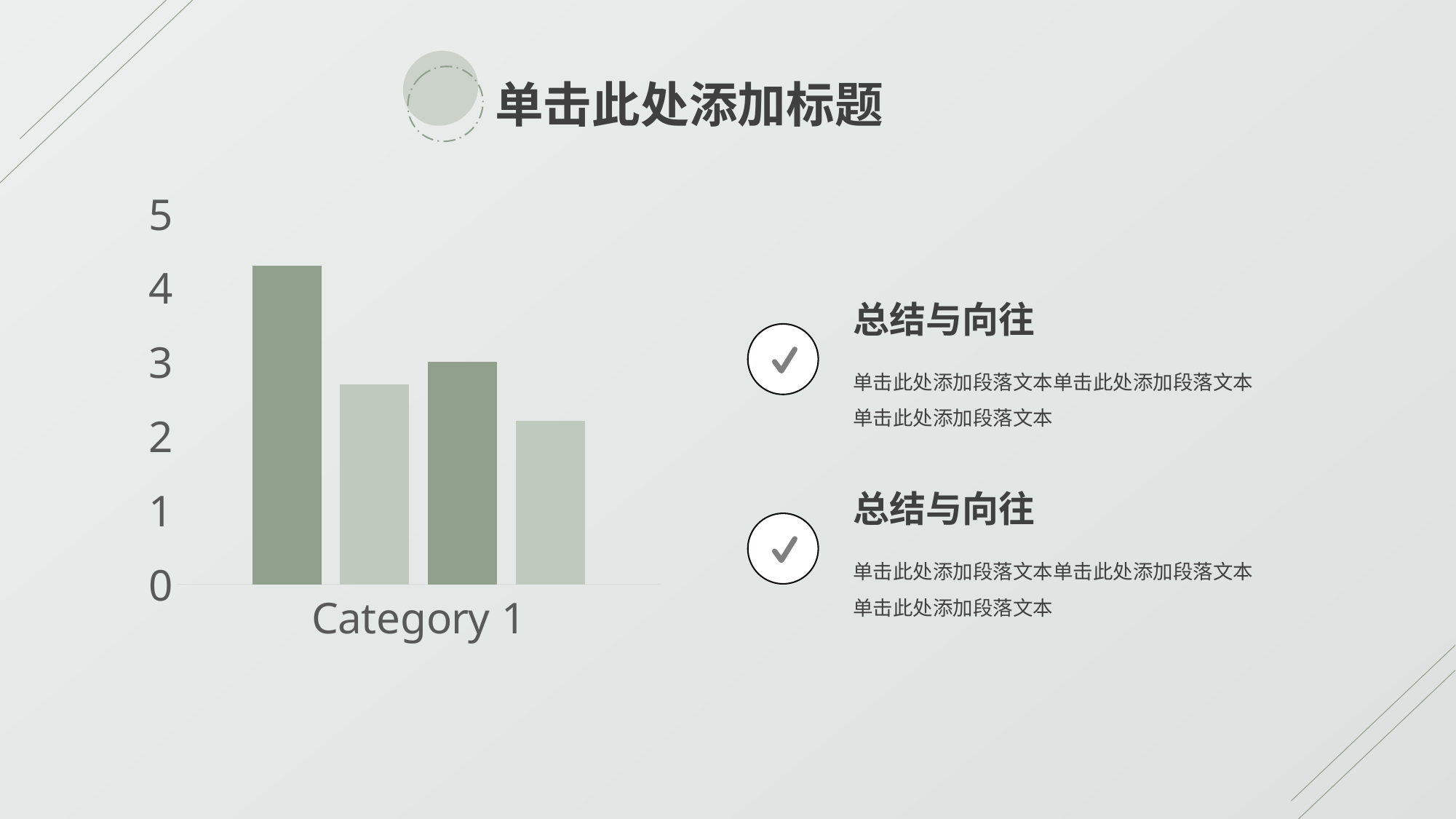
What kind of chart is shown on the slide? bar chart Is the value of the rightmost bar greater or less than 2? greater What is the label of the category on the x axis? Category 1 Which bar is the tallest in the chart? the leftmost (first) bar How many categories are shown on the x axis of the chart? 1 Which bar is the shortest in the chart? the rightmost (fourth) bar Is the value of the rightmost bar greater or less than 3? less How many bars are plotted in the chart? 4 What is the highest value shown on the y axis of the chart? 5 Which is larger, the first bar or the second bar from the left? the first bar Is the value of the second bar from the left greater or less than 3? less